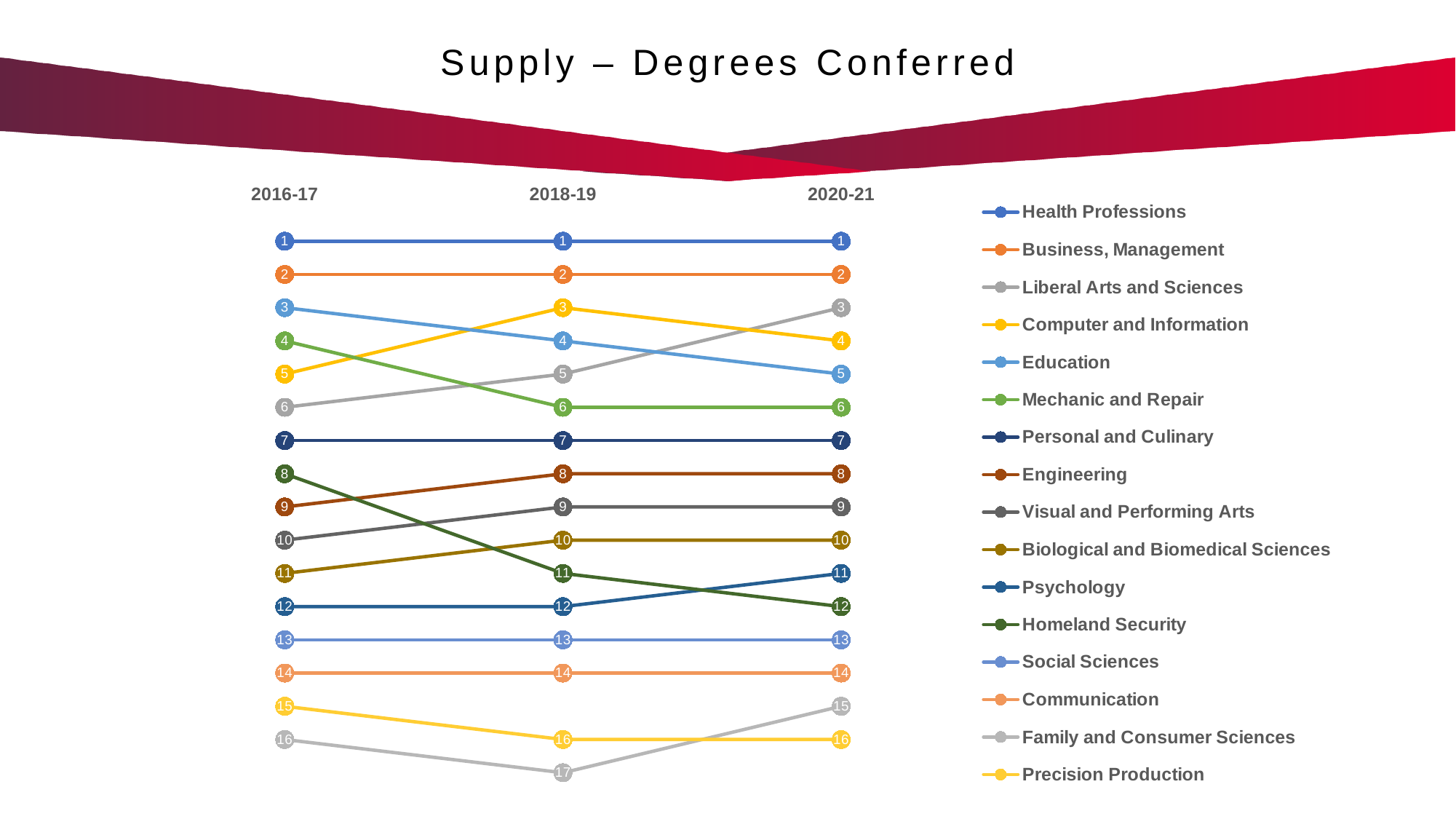
How many time periods are shown on the x axis? 3 What is the title of the chart? Supply – Degrees Conferred Which series holds rank 1 in every period shown? Health Professions What rank does Homeland Security hold in 2016-17? 8 What rank does Family and Consumer Sciences hold in 2018-19? 17 What rank does Psychology hold in 2020-21? 11 Does the rank number for Education rise or fall from 2016-17 to 2020-21? rise By how many positions does the rank of Liberal Arts and Sciences change between 2016-17 and 2020-21? 3 How many series does the legend list? 16 What rank does Liberal Arts and Sciences hold in 2020-21? 3 What rank does Computer and Information hold in 2018-19? 3 What kind of chart is shown on the slide? line chart